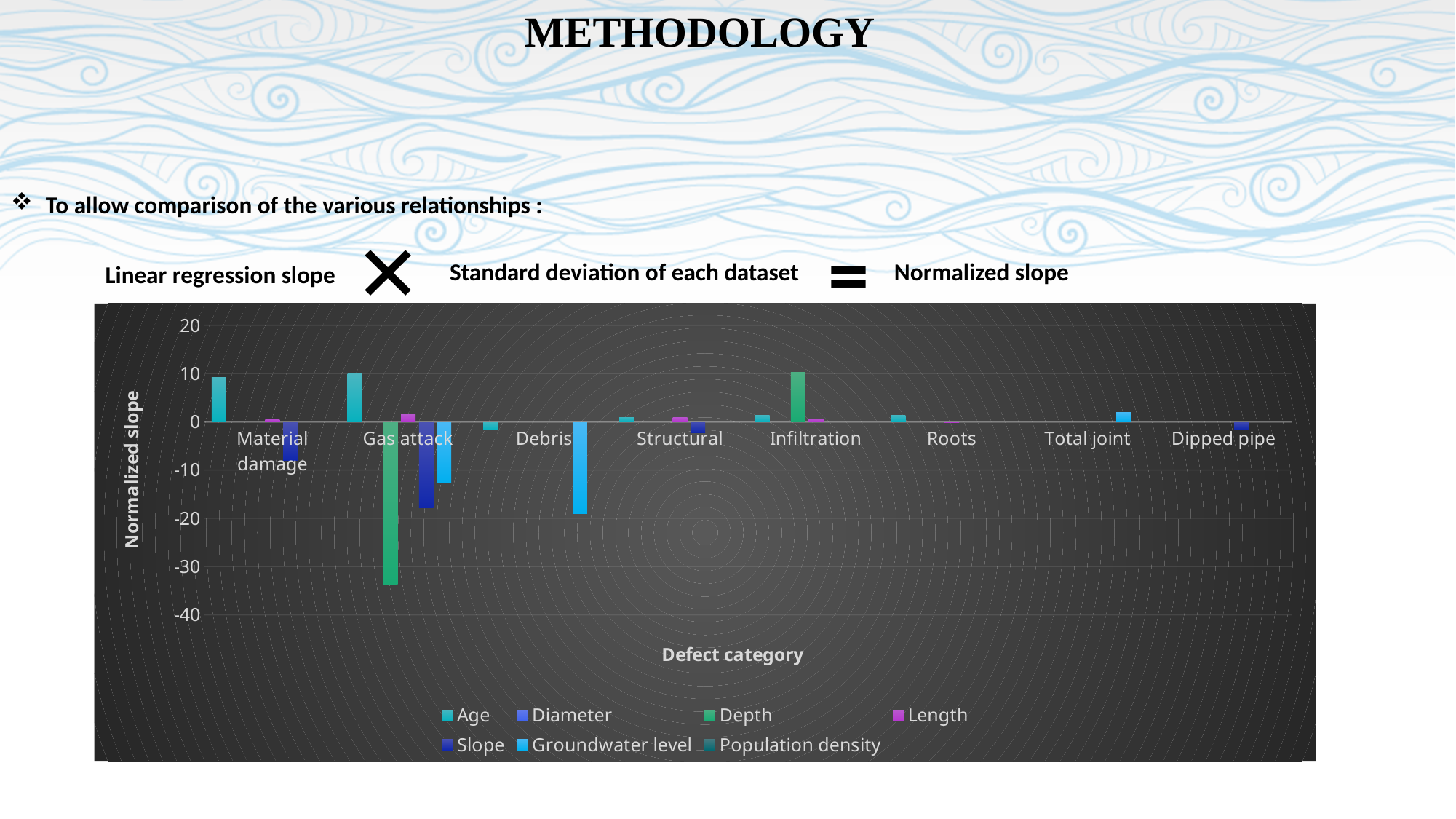
How many series does the chart's legend list? 7 Is the Groundwater level value for Debris greater or less than -10? less Is the Slope value for Gas attack greater or less than -10? less Which is lower, the Depth value for Gas attack or the Groundwater level value for Debris? Depth for Gas attack Is the Age value for Material damage greater or less than 0? greater What is the title of the chart's vertical axis? Normalized slope Which is larger, the Age value for Gas attack or the Age value for Debris? Age for Gas attack What is the title of the chart's horizontal axis? Defect category Which series and defect category has the lowest (most negative) bar in the chart? Depth for Gas attack How many defect categories are shown on the x axis of the chart? 8 What kind of chart is shown on the slide? bar chart